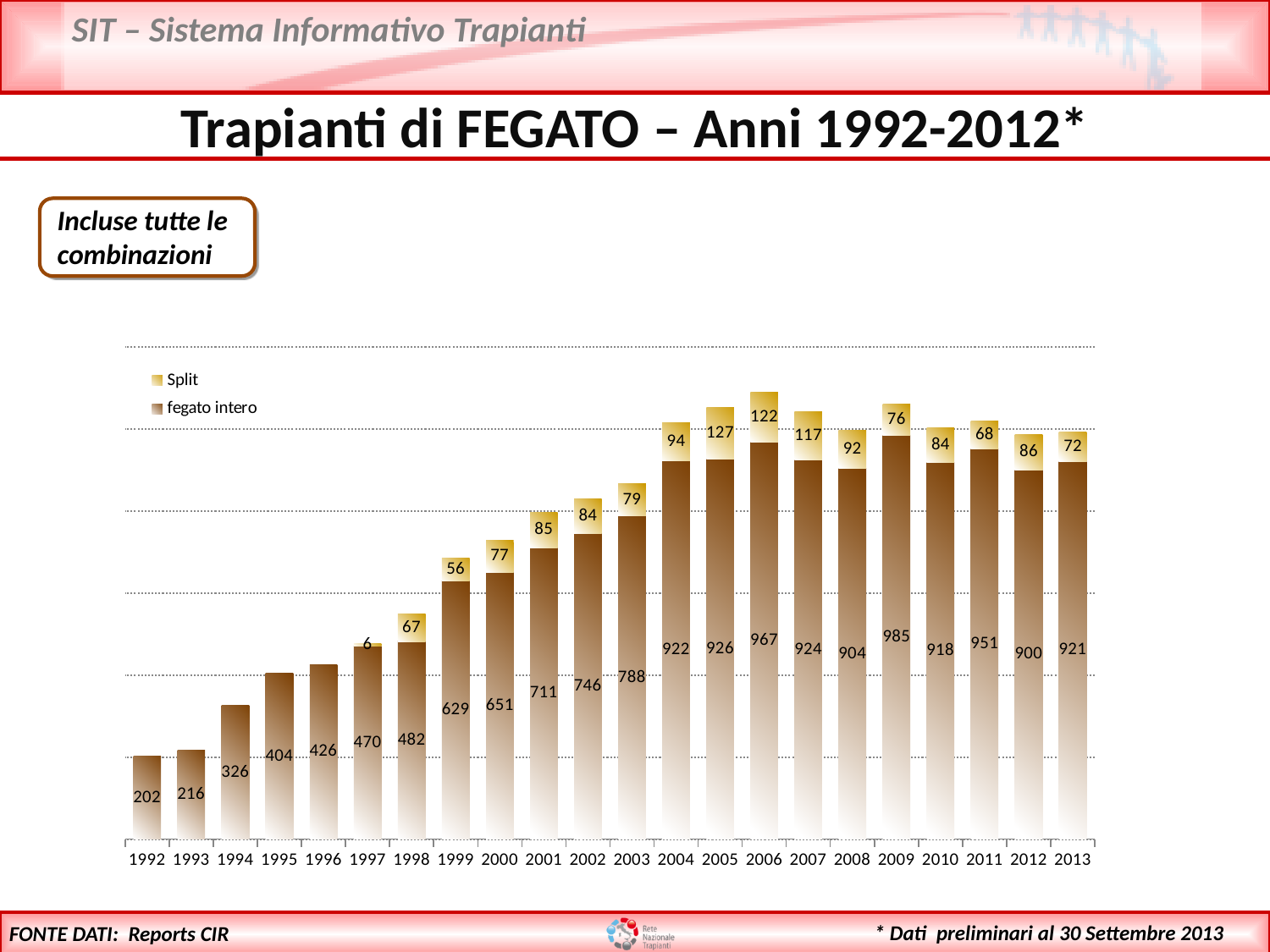
What is the 'fegato intero' value for 1992? 202 What is the 'Split' value for 2005? 127 Which year has the highest 'Split' value? 2005 What is the value of 'fegato intero' for 2006? 967 How many series does the legend list? 2 Which year has the highest 'fegato intero' value? 2009 What is the total of the stacked bar for 2006 (fegato intero plus Split)? 1089 What is the difference between the 'fegato intero' values for 2013 and 2012? 21 Which year has the lowest 'fegato intero' value? 1992 Which is larger, the 'Split' value for 2007 or for 2008? 2007 What kind of chart is shown on the slide? Stacked bar chart How many years are shown on the x axis? 22